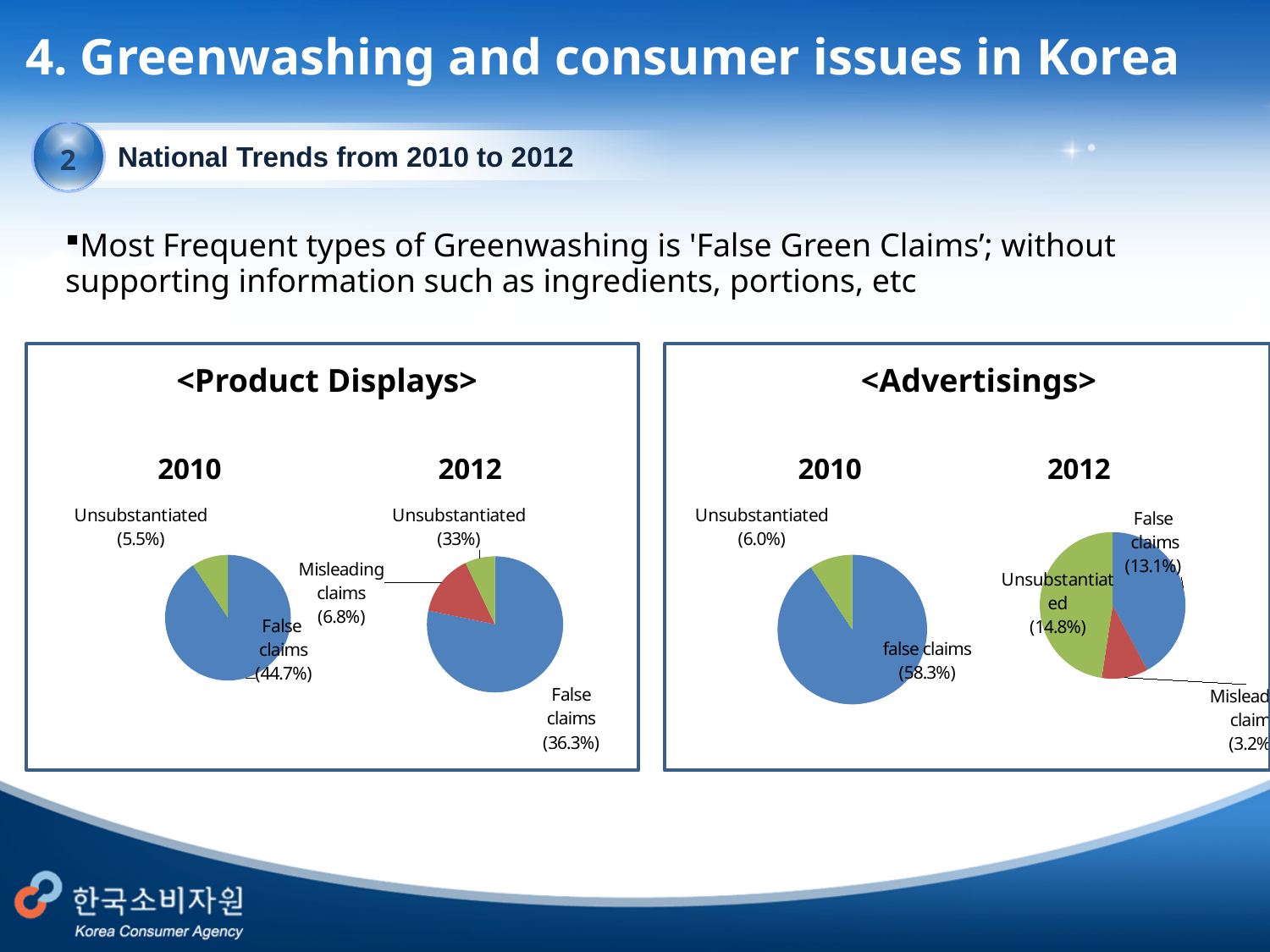
In the Product Displays 2012 pie chart, which category has the largest slice? False claims In the Product Displays 2010 pie chart, what is the share for False claims? 44.7% In the Advertisings 2010 pie chart, what is the share for false claims? 58.3% In the Advertisings 2010 pie chart, what is the share for Unsubstantiated? 6.0% In the Advertisings 2012 pie chart, what is the share for Unsubstantiated? 14.8% In the Product Displays 2012 pie chart, what is the share for Unsubstantiated? 33% In the Product Displays 2012 pie chart, what is the share for Misleading claims? 6.8% In the Product Displays 2010 pie chart, what is the share for Unsubstantiated? 5.5% How many slices does the Product Displays 2012 pie chart have? 3 In the Advertisings 2012 pie chart, which is larger, False claims or Unsubstantiated? Unsubstantiated What kind of charts are shown on the slide? Pie charts